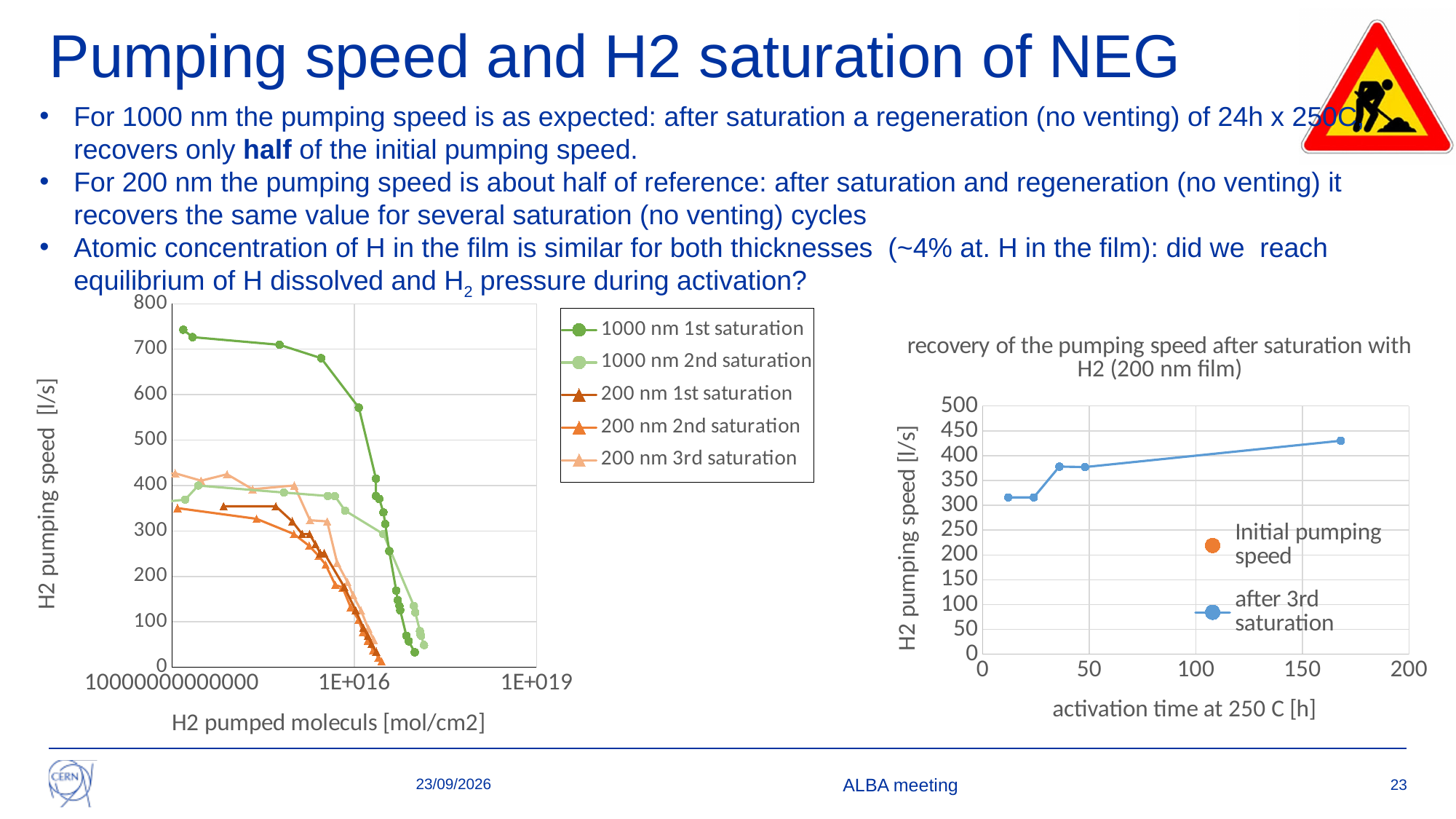
What is the y-axis label of the left chart? H2 pumping speed [l/s] How many series does the legend of the right chart list? 2 How many series does the legend of the left chart list? 5 In the right chart, is the 'after 3rd saturation' value at the shortest activation time greater or less than 350? less In the left chart, is the first (leftmost) value of the 200 nm 1st saturation series greater or less than 400? less In the left chart, do the pumping speed values rise or fall as the number of H2 pumped molecules increases? fall What kind of chart is the left chart on the slide? line chart In the left chart, which series starts at a higher pumping speed: 1000 nm 1st saturation or 200 nm 1st saturation? 1000 nm 1st saturation In the right chart, does the 'after 3rd saturation' pumping speed rise or fall as activation time increases? rise In the right chart, is the 'after 3rd saturation' value at the longest activation time greater or less than 400? greater What is the title of the right chart? recovery of the pumping speed after saturation with H2 (200 nm film)